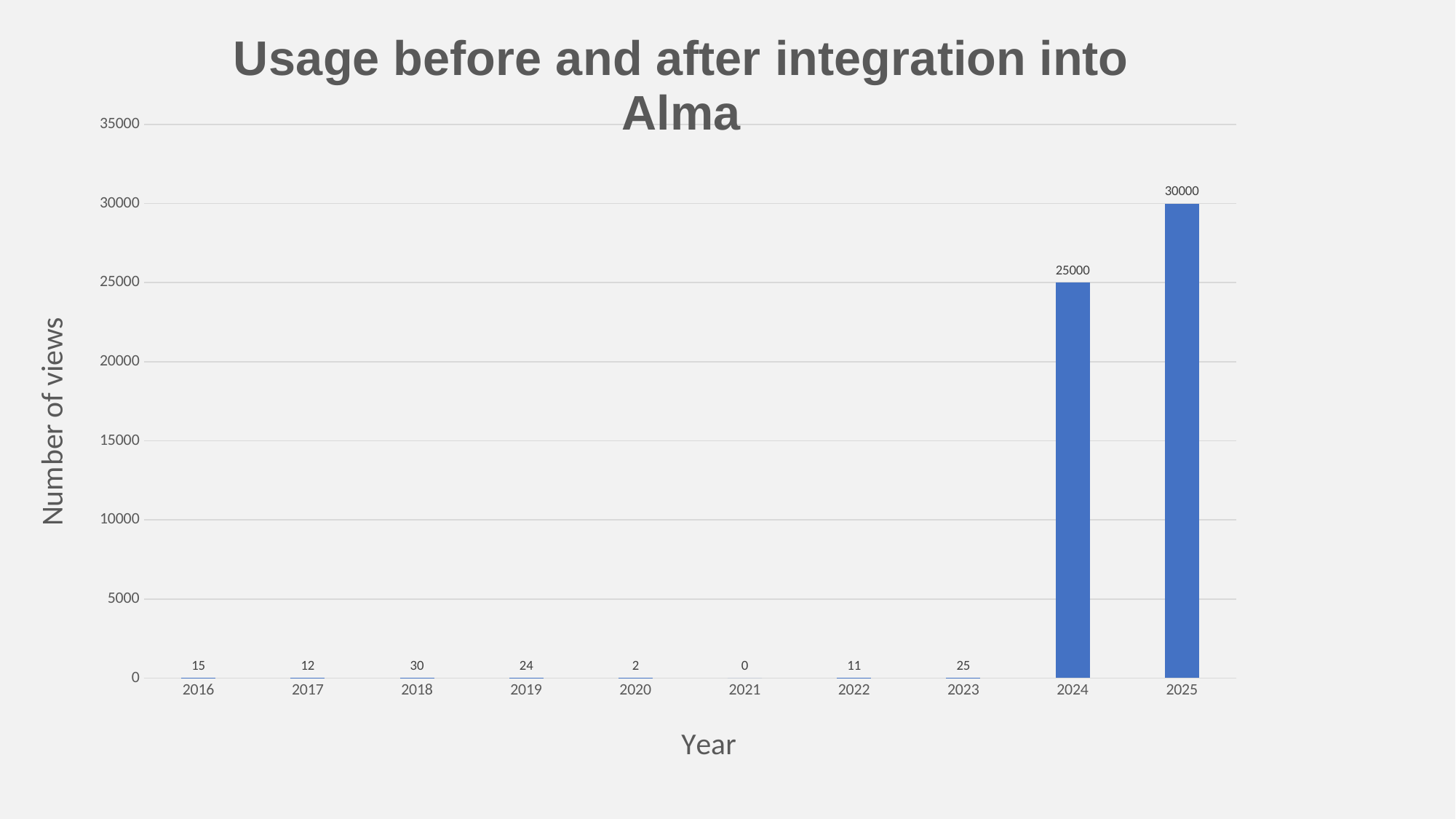
What is the number of views for 2021? 0 What kind of chart is shown on the slide? Bar chart Which year has the lowest number of views? 2021 Which year has more views, 2023 or 2022? 2023 What is the title of the chart? Usage before and after integration into Alma Which year has the highest number of views? 2025 What is the number of views for 2018? 30 What is the difference in number of views between 2025 and 2024? 5000 What is the number of views for 2024? 25000 Is the value for 2024 greater or less than 20000? greater What is the difference in number of views between 2019 and 2017? 12 How many years are shown on the x axis? 10